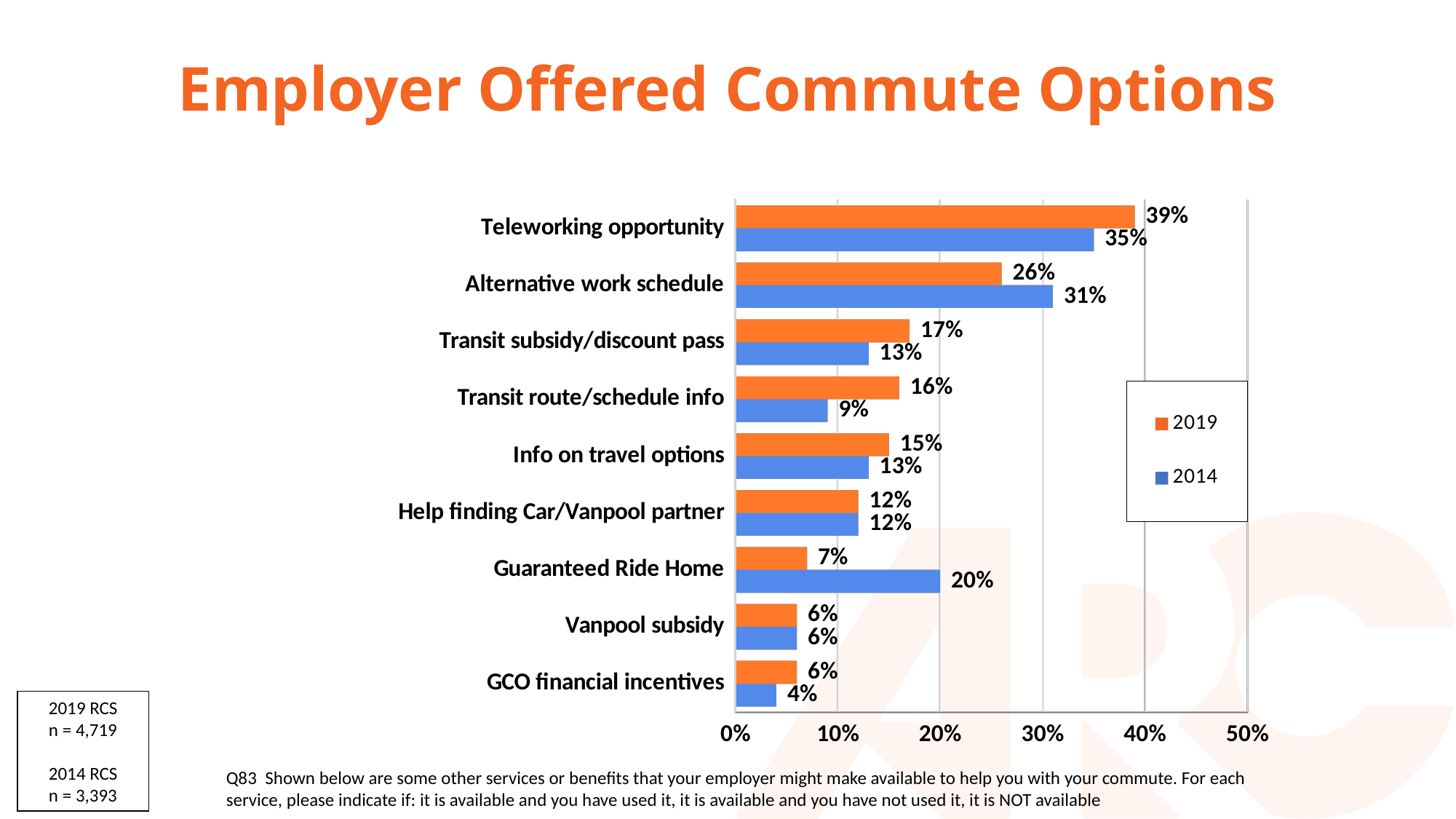
How many categories are shown on the chart? 9 What is the 2014 value for Transit route/schedule info? 9% Which is larger for Alternative work schedule, the 2019 value or the 2014 value? 2014 Which category has the highest 2019 value? Teleworking opportunity What is the 2014 value for Guaranteed Ride Home? 20% What is the difference between the 2014 and 2019 values for Guaranteed Ride Home? 13% Is the 2014 value for Teleworking opportunity greater or less than 30%? greater Which category has the lowest 2014 value? GCO financial incentives What kind of chart is shown on the slide? bar chart How many series does the legend list? 2 Which colour represents the 2014 series? blue What is the 2019 value for Teleworking opportunity? 39%